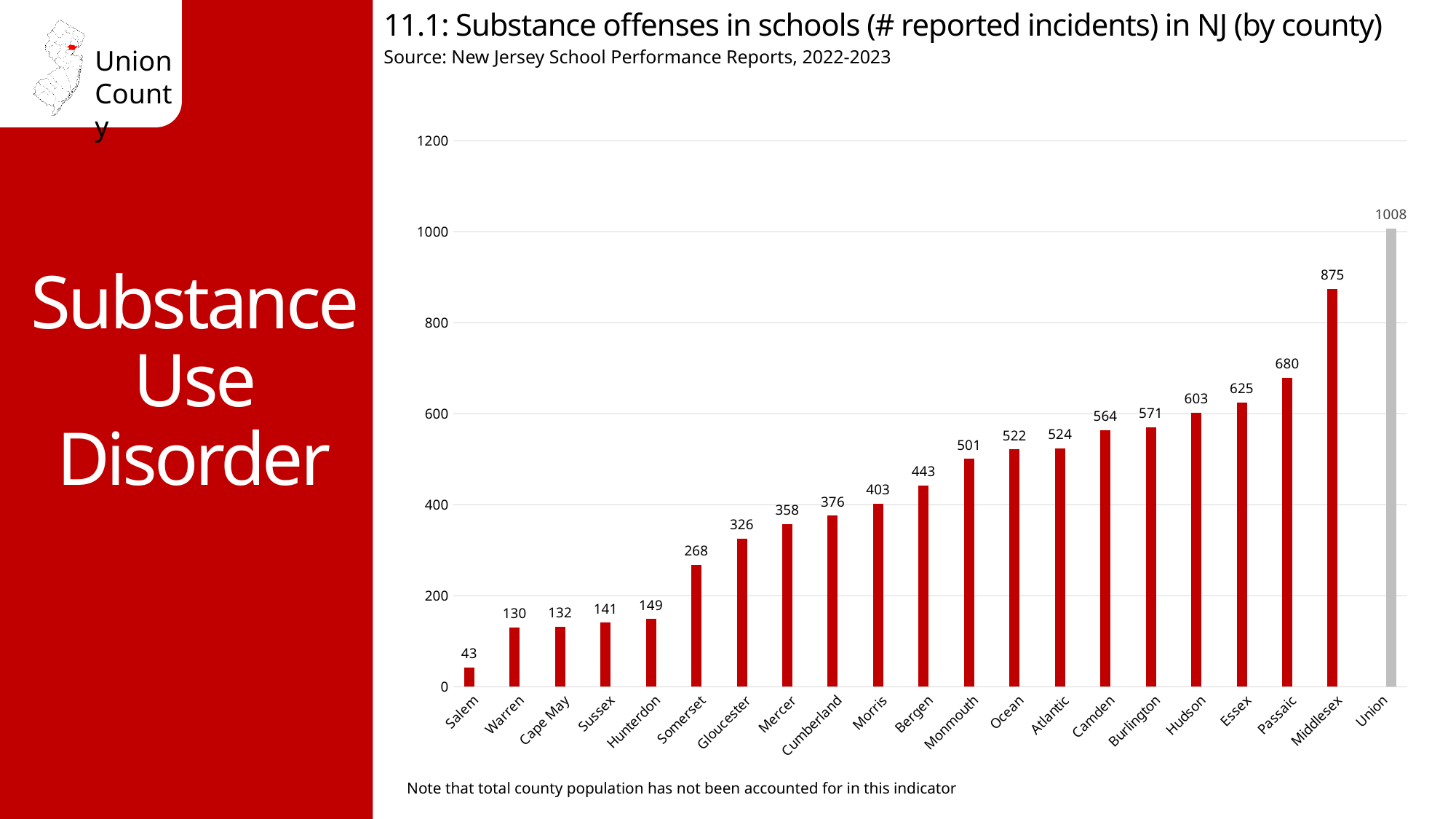
What is the value shown for Middlesex county? 875 What is the value shown for Salem county? 43 What is the difference between the values for Union and Middlesex? 133 Do the values rise or fall moving from left to right along the x axis? Rise Which county has a larger value, Hudson or Essex? Essex How many counties are shown on the chart? 21 What kind of chart is shown on the slide? Bar chart Which county has the lowest number of reported incidents? Salem Is the value for Passaic greater or less than 600? greater What is the number of reported substance offense incidents in schools for Union county? 1008 Which county has the highest number of reported incidents? Union What is the source cited for the chart data? New Jersey School Performance Reports, 2022-2023